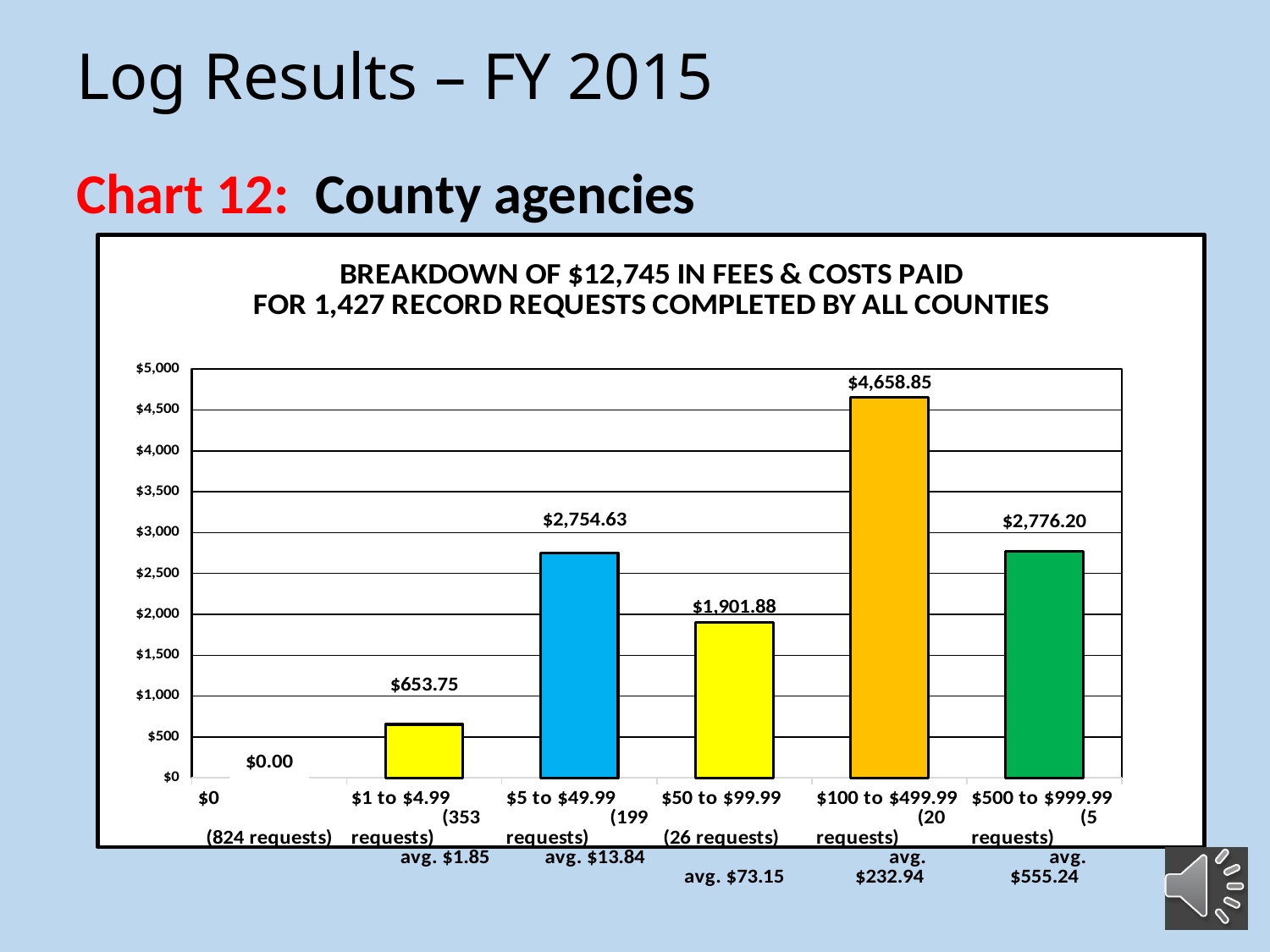
What is the value of the bar for the $100 to $499.99 category? $4,658.85 Which is larger, the bar for $5 to $49.99 or the bar for $50 to $99.99? $5 to $49.99 Which category has the lowest bar? $0 What is the value of the bar for the $1 to $4.99 category? $653.75 What kind of chart is shown on the slide? bar chart How many categories are shown on the x axis? 6 What is the total amount of fees and costs stated in the chart title? $12,745 Is the value for the $500 to $999.99 category greater or less than $2,500? greater What is the difference between the $500 to $999.99 bar and the $5 to $49.99 bar? $21.57 What is the difference between the $100 to $499.99 bar and the $50 to $99.99 bar? $2,756.97 What is the value of the bar for the $50 to $99.99 category? $1,901.88 Which category has the highest bar? $100 to $499.99